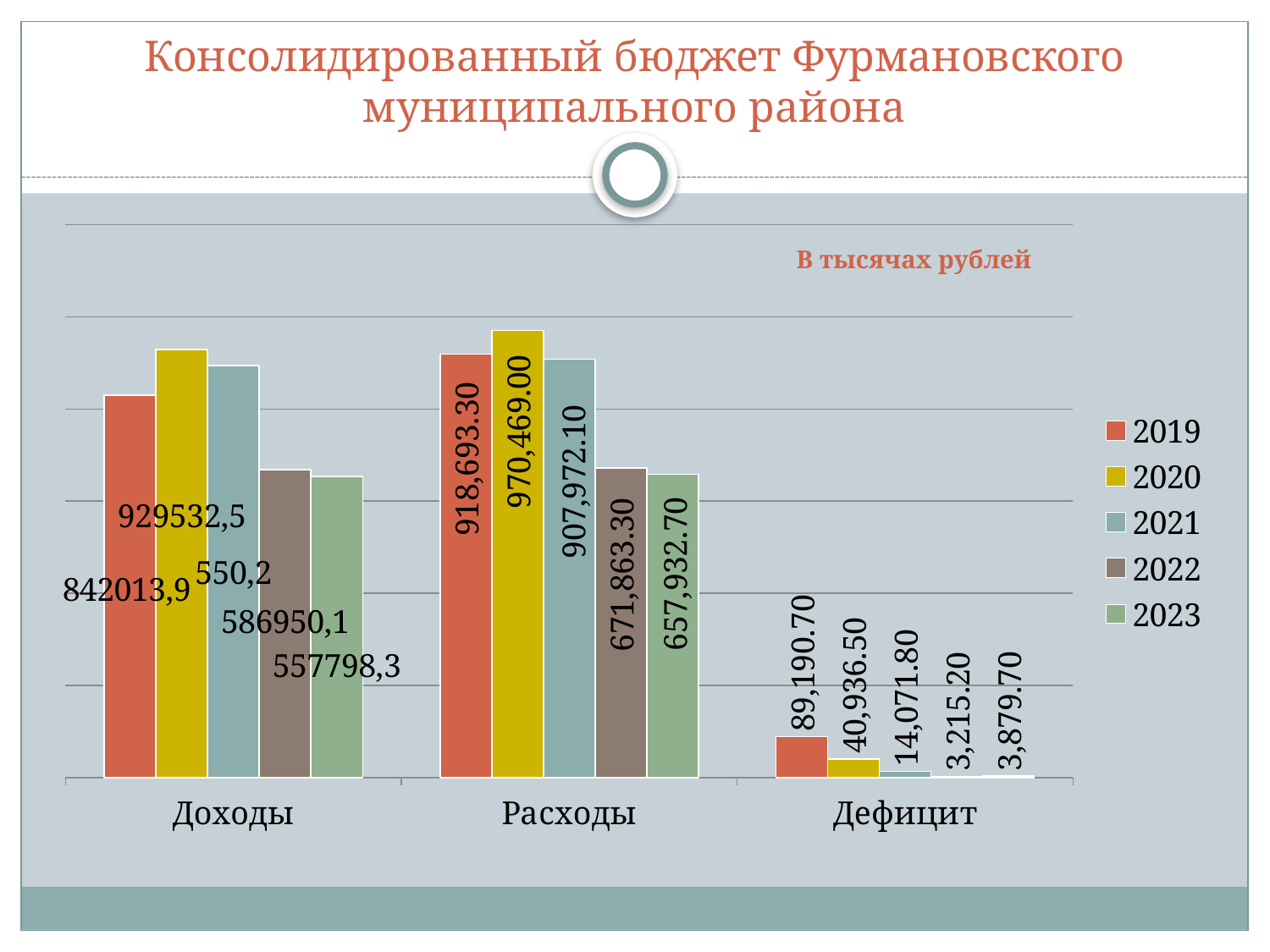
What kind of chart is shown on the slide? Bar chart How many series does the legend list? 5 What is the value for 2019 in the Дефицит category? 89,190.70 Which year has the lowest value in the Дефицит category? 2022 What is the value for 2023 in the Доходы category? 557798,3 In the Дефицит category, which is larger: the value for 2020 or the value for 2021? 2020 What is the difference between the 2019 and 2020 values in the Дефицит category? 48,254.20 How many categories are shown on the x axis? 3 What is the difference between the 2020 and 2019 values in the Расходы category? 51,775.70 Which year has the highest value in the Расходы category? 2020 What is the value for 2019 in the Доходы category? 842013,9 What is the value for 2020 in the Расходы category? 970,469.00